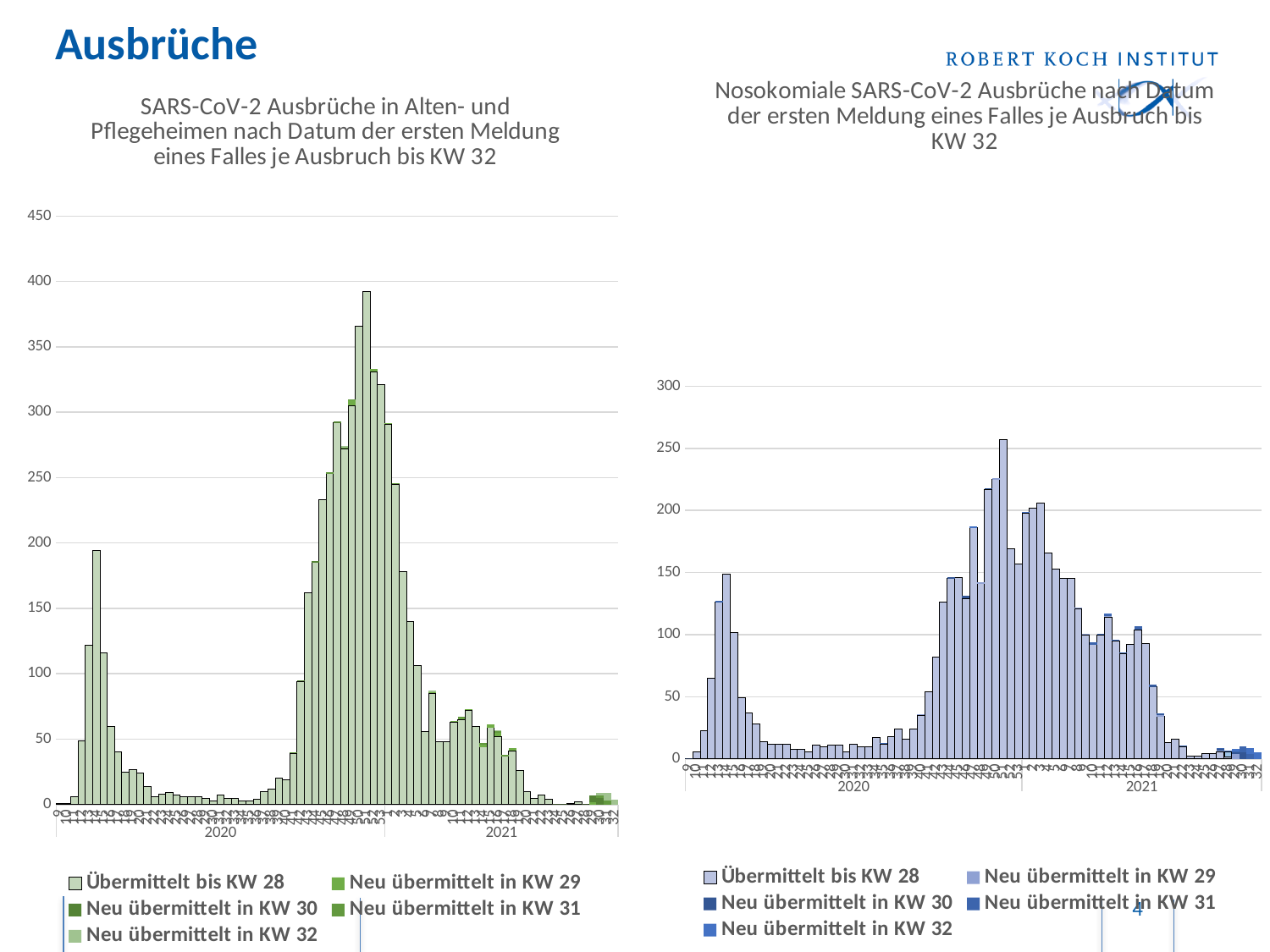
In the right chart, is the highest bar greater or less than 200? greater Which chart has the higher maximum value on its y axis, the left chart or the right chart? the left chart In the left chart, is the highest bar greater or less than 400? less How many series does the legend of the left chart list? 5 What kind of chart is the right chart, 'Nosokomiale SARS-CoV-2 Ausbrüche'? bar chart What is the highest value shown on the y axis of the right chart? 300 In the left chart, is the highest bar greater or less than 350? greater What kind of chart is the left chart, 'SARS-CoV-2 Ausbrüche in Alten- und Pflegeheimen'? bar chart Which two years are labelled on the x axis of the left chart? 2020 and 2021 How many series does the legend of the right chart list? 5